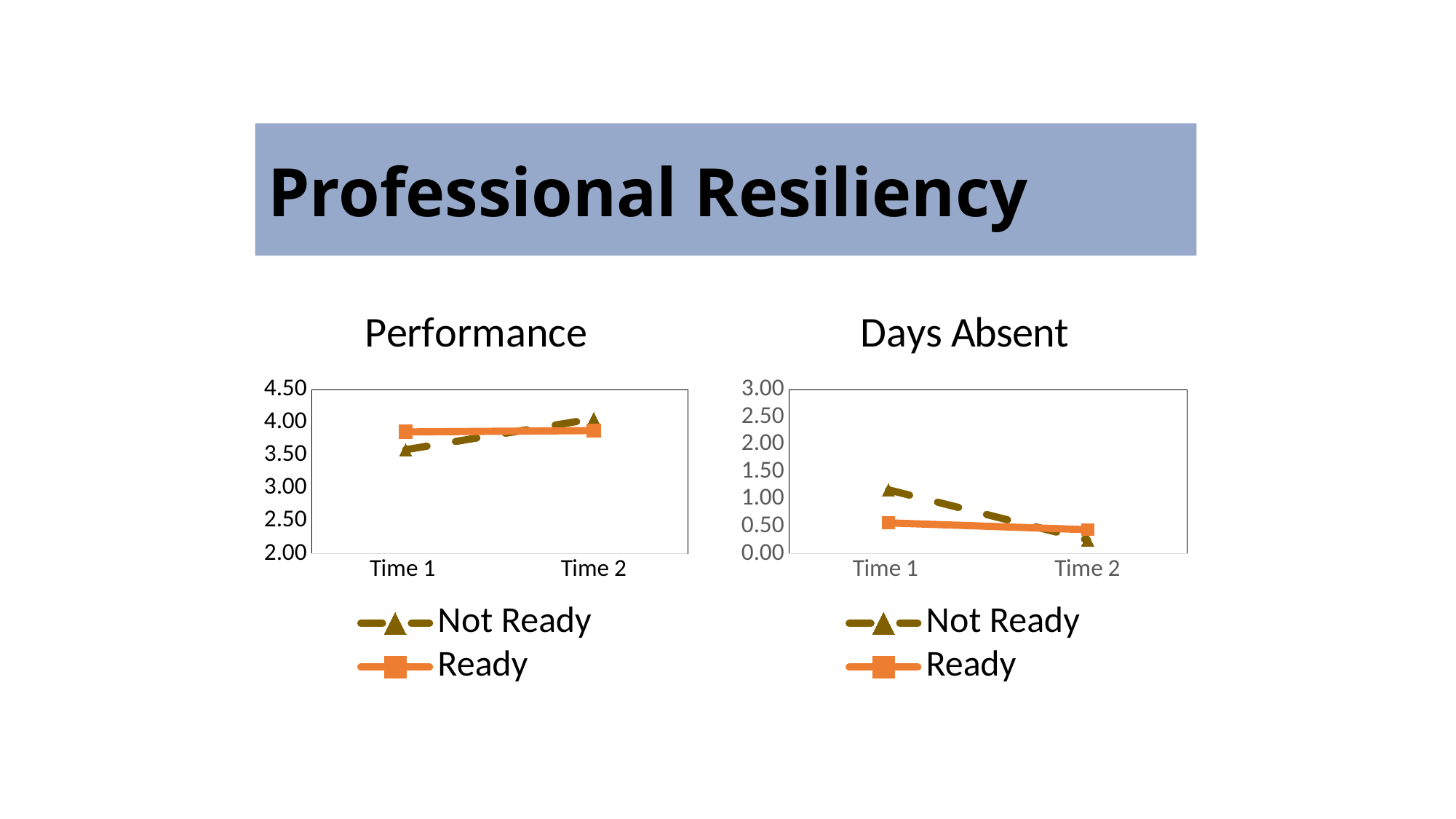
In the Performance chart, is the Not Ready value at Time 1 greater or less than 4.00? less In the Performance chart, does the Not Ready line rise or fall from Time 1 to Time 2? rise How many series does the legend of the Days Absent chart list? 2 In the Days Absent chart, is the Not Ready value at Time 1 greater or less than 1.00? greater What kind of chart is the Performance chart? line chart In the Days Absent chart, does the Not Ready line rise or fall from Time 1 to Time 2? fall What is the title of the chart on the right side of the slide? Days Absent In the Days Absent chart, is the Ready value at Time 1 greater or less than 1.00? less In the Performance chart, which series has the higher value at Time 1, Not Ready or Ready? Ready In the Days Absent chart, which series has the higher value at Time 1, Not Ready or Ready? Not Ready How many time points are shown on the x axis of the Performance chart? 2 In the Days Absent chart, which series has the lower value at Time 2, Not Ready or Ready? Not Ready